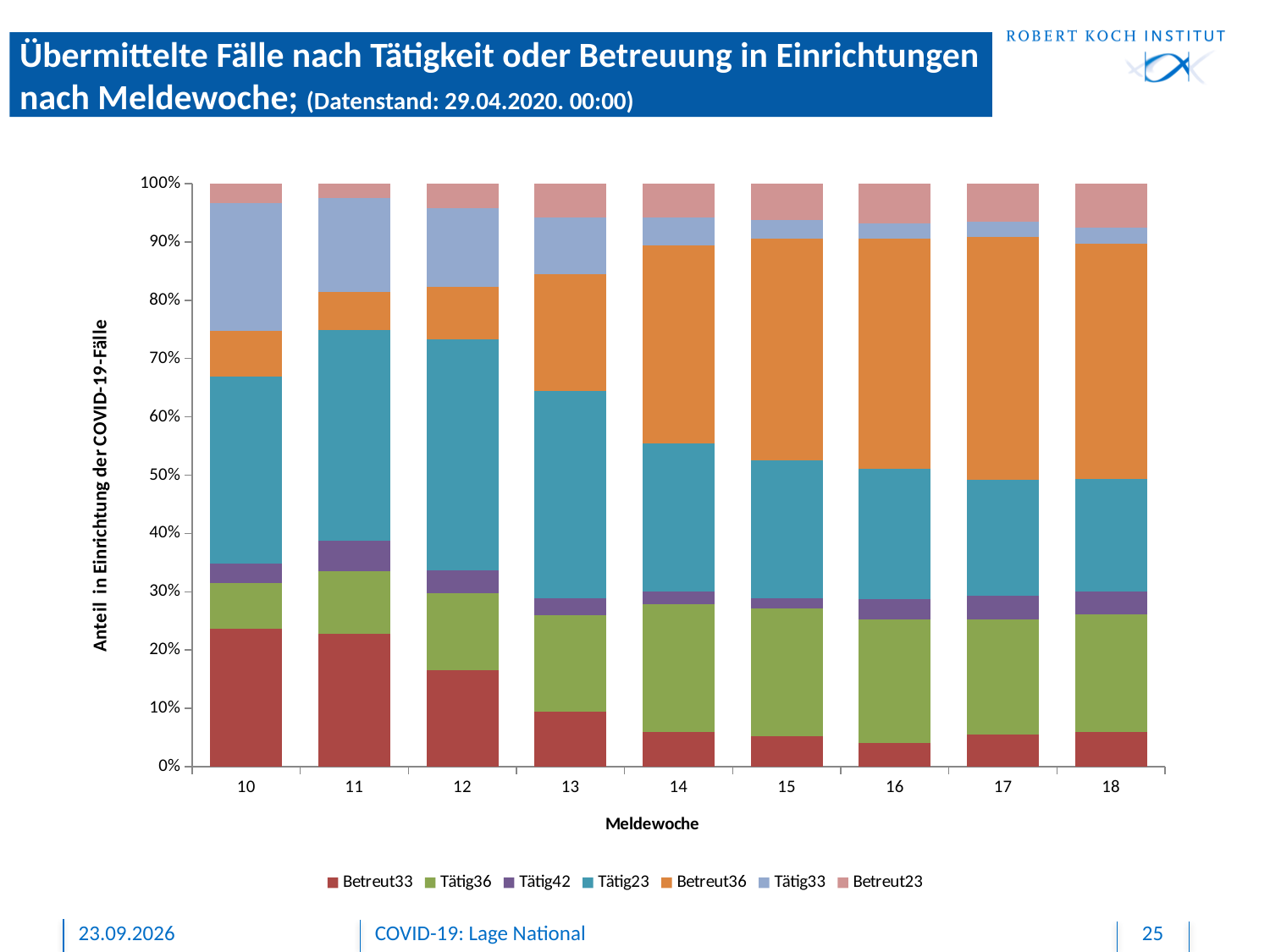
What is the label of the x axis? Meldewoche What kind of chart is shown on the slide? Stacked bar chart Is the Betreut33 share for Meldewoche 10 greater or less than 20%? greater How many Meldewochen (reporting weeks) are shown on the x axis? 9 Does the share of Betreut33 rise or fall from Meldewoche 10 to Meldewoche 18? Fall Which has the larger Betreut36 share, Meldewoche 10 or Meldewoche 15? Meldewoche 15 Is the Betreut33 share for Meldewoche 16 greater or less than 10%? less Is the Betreut33 share for Meldewoche 18 greater or less than 10%? less How many series does the legend list? 7 What is the total of each stacked bar in the chart? 100% What is the Datenstand (data status) given in the slide title? 29.04.2020. 00:00 Which has the larger Betreut33 share, Meldewoche 10 or Meldewoche 18? Meldewoche 10